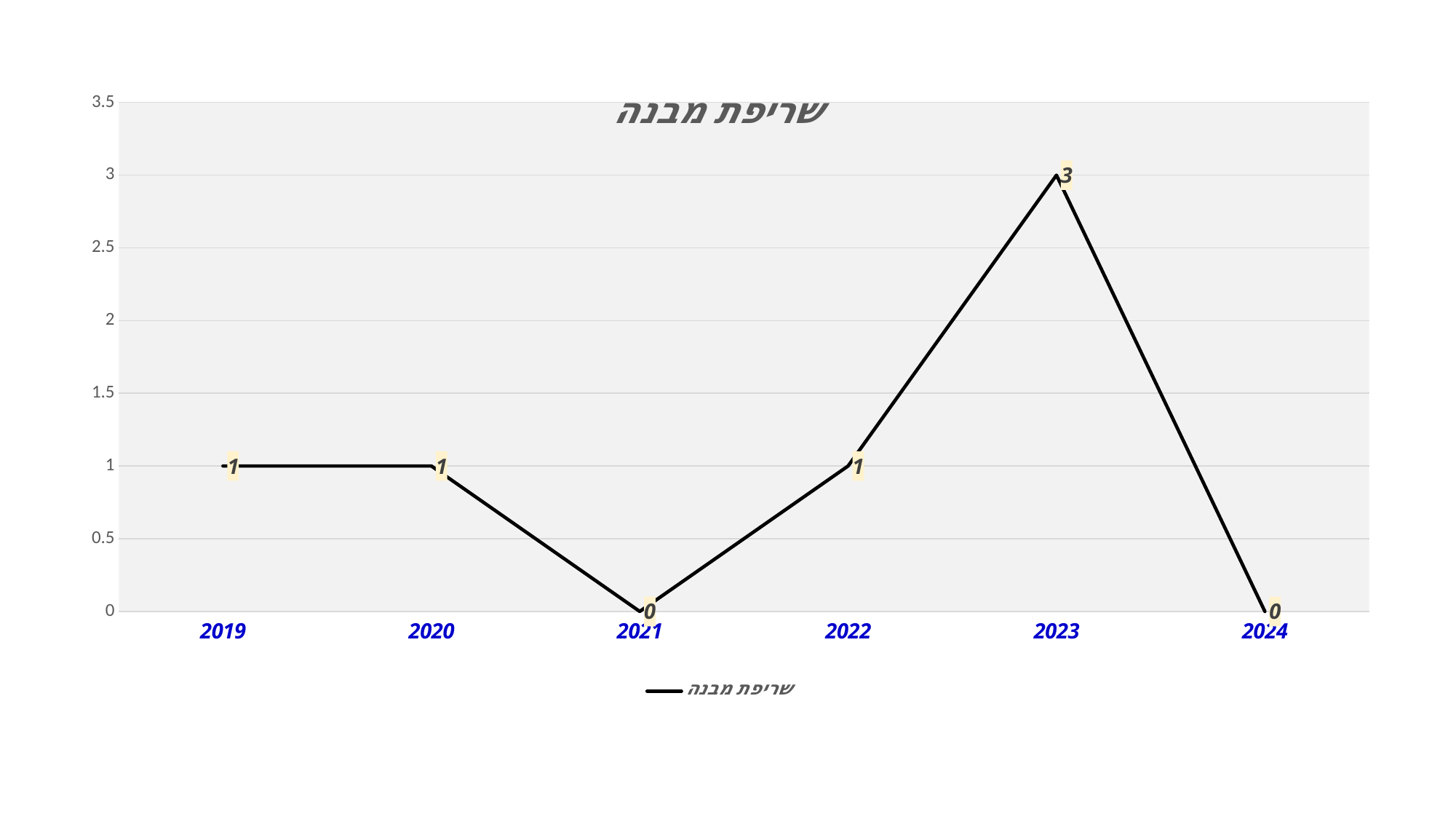
Is the value for 2023 greater or less than 2? greater What is the value for 2019? 1 Which is larger, the value for 2020 or the value for 2021? 2020 What is the value for 2022? 1 Does the value rise or fall from 2023 to 2024? fall What is the difference between the values for 2023 and 2022? 2 What is the value for 2021? 0 Which year has the highest value? 2023 What kind of chart is shown? line chart How many years are plotted on the x axis? 6 How many series does the legend list? 1 What is the value for 2023? 3